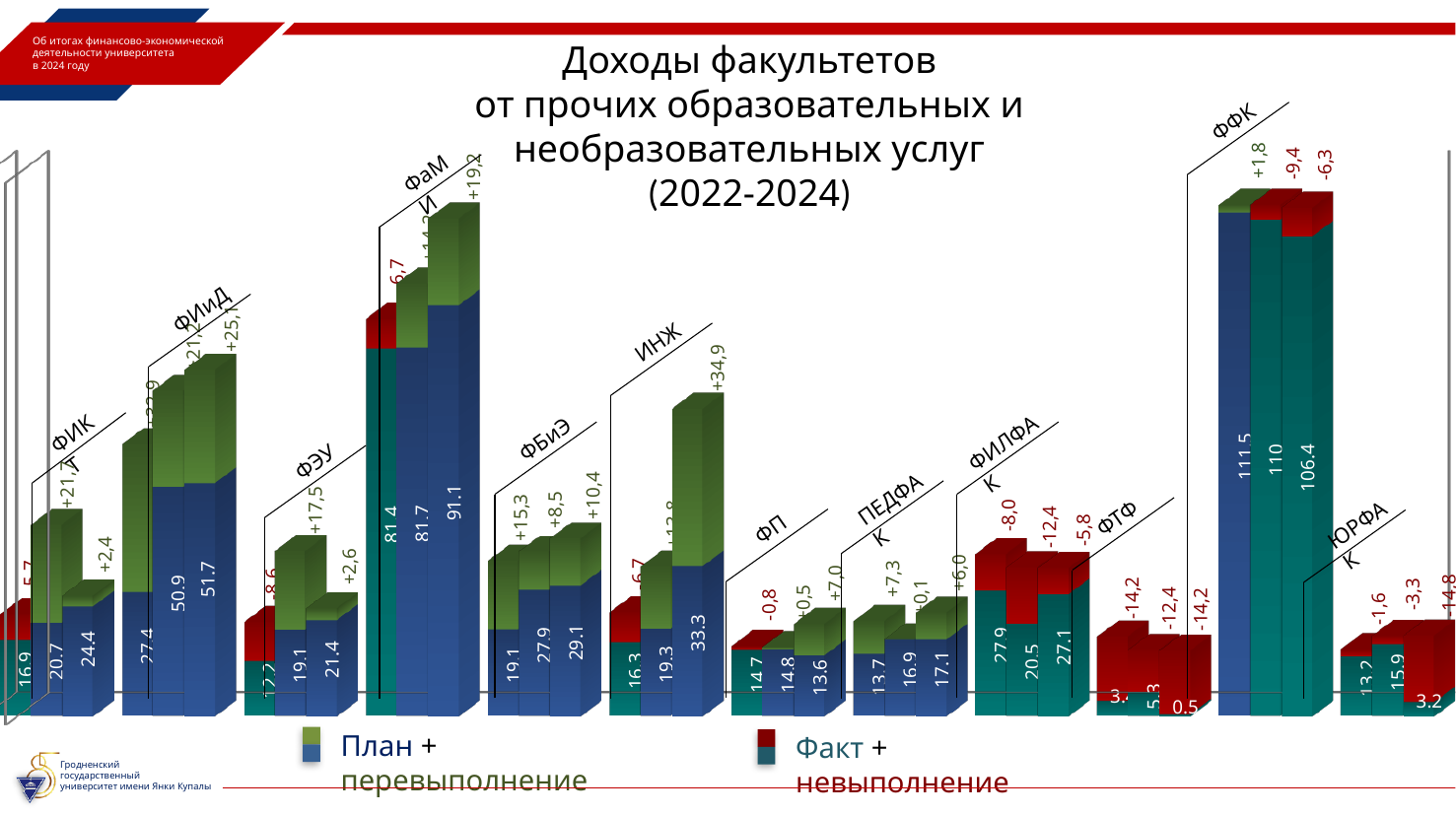
Do the values for ФФК rise or fall from the first bar to the third bar? fall What is the difference between the third (2024) bar and the first (2022) bar for ФаМИ? 9.7 Which faculty has the highest value for the third (2024) bar? ФФК What is the value of the third (2024) bar for ИНЖ? 33.3 How many faculties are shown on the chart? 12 Which is larger: the third (2024) bar for ФИиД or the third (2024) bar for ИНЖ? ФИиД What is the value of the third (2024) bar for ФаМИ? 91.1 What is the value of the first (2022) bar for ФФК? 111.5 What is the title of the chart? Доходы факультетов от прочих образовательных и необразовательных услуг (2022-2024) Which faculty has the lowest value for the third (2024) bar? ФТФ How many entries does the legend list? 2 What kind of chart is shown on the slide? bar chart